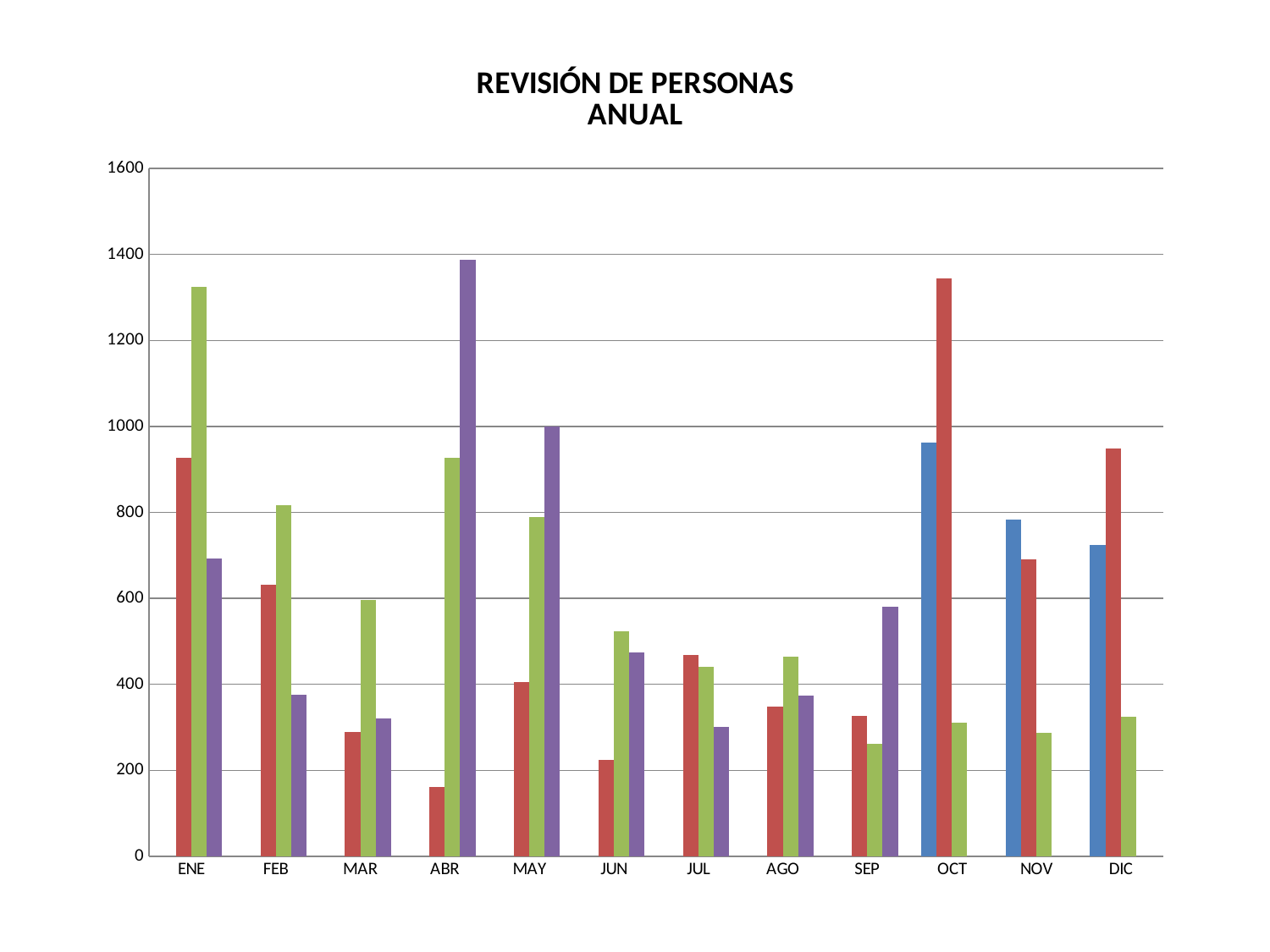
What is the title of the chart? REVISIÓN DE PERSONAS ANUAL For OCT, which bar is larger, the blue bar or the red bar? red In which months does a blue bar appear? OCT, NOV, DIC Is the value of the purple bar for ABR greater or less than 1200? greater Is the value of the red bar for MAR greater or less than 400? less Is the value of the red bar for ABR greater or less than 200? less Which month contains the tallest bar in the chart? ABR For ENE, which bar is larger, the red bar or the green bar? green What kind of chart is shown on the slide? bar chart How many months (categories) are shown on the x axis? 12